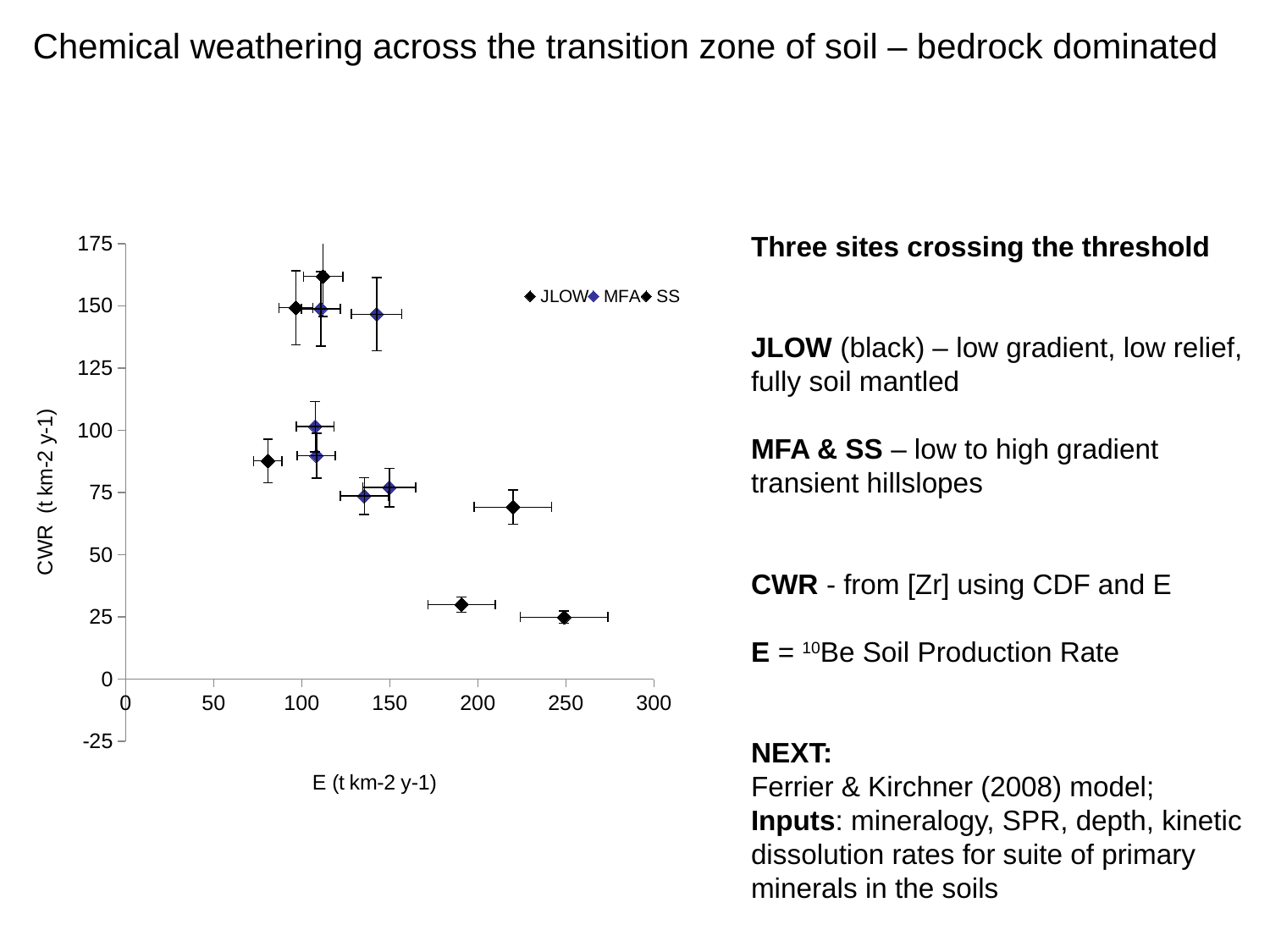
What are the series names listed in the chart legend? JLOW, MFA, SS Are all plotted E values on the chart less than 300? yes Is the highest CWR value plotted on the chart greater or less than 150? greater How many series does the chart legend list? 3 Overall, does CWR rise or fall as E increases along the x axis? fall What is the label of the y axis of the chart? CWR (t km-2 y-1) Is the E value of the point with the highest CWR greater or less than 150? less What is the maximum value shown on the x axis of the chart? 300 What kind of chart is shown on the slide? scatter chart